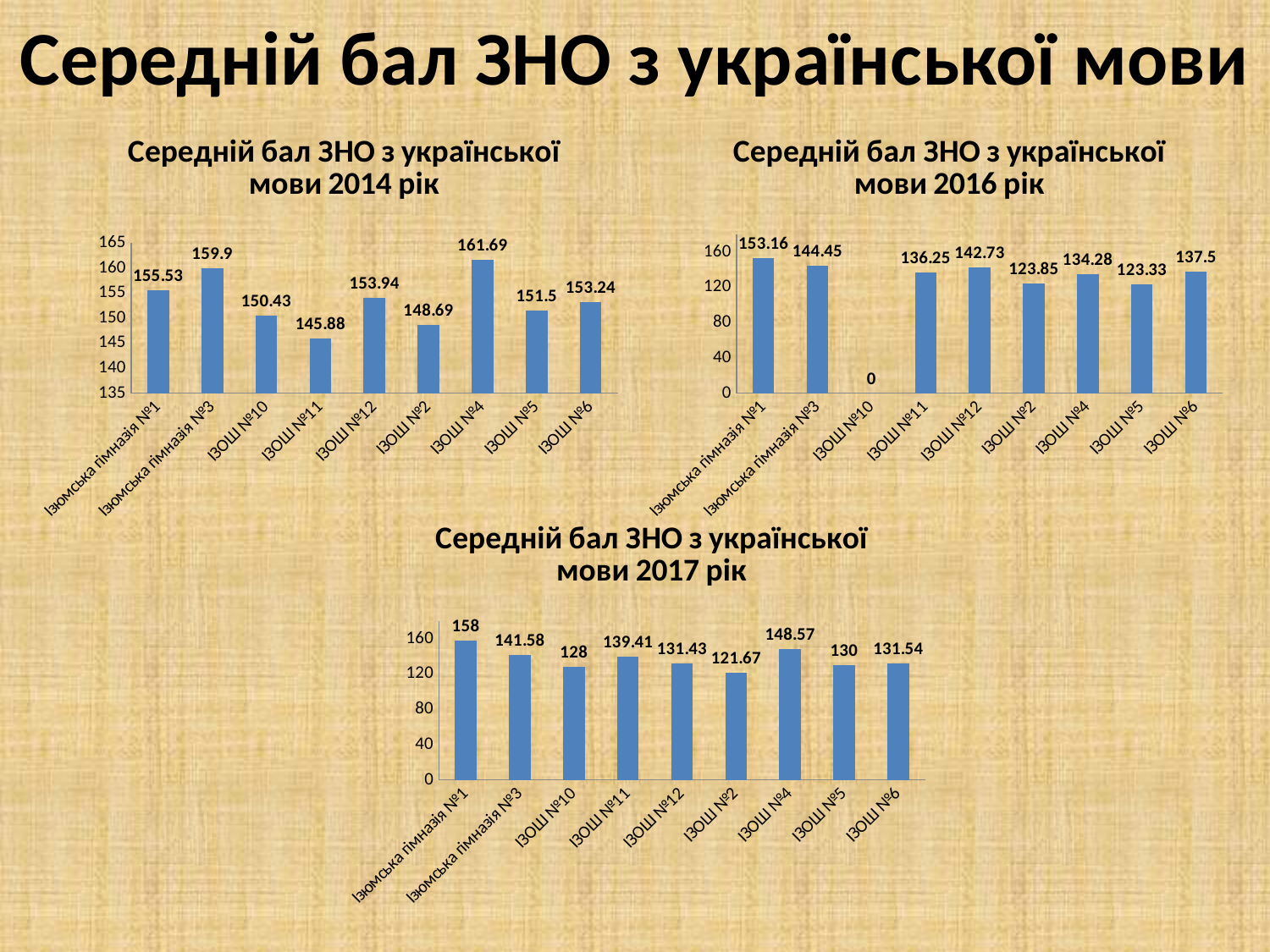
In the 2016 chart, which category has the highest value? Ізюмська гімназія №1 In the 2016 chart, which is larger: ІЗОШ №6 or ІЗОШ №4? ІЗОШ №6 What type of chart is the 2014 chart? Bar chart In the 2014 chart (Середній бал ЗНО з української мови 2014 рік), what is the value for ІЗОШ №4? 161.69 In the 2017 chart (Середній бал ЗНО з української мови 2017 рік), what is the value for ІЗОШ №4? 148.57 In the 2014 chart, what is the difference between Ізюмська гімназія №3 and ІЗОШ №10? 9.47 In the 2016 chart, what value is shown for ІЗОШ №10? 0 In the 2014 chart, which category has the lowest value? ІЗОШ №11 In the 2016 chart (Середній бал ЗНО з української мови 2016 рік), what is the value for ІЗОШ №12? 142.73 In the 2017 chart, what is the difference between Ізюмська гімназія №1 and ІЗОШ №5? 28 How many categories are shown in the 2017 chart? 9 In the 2017 chart, which category has the lowest value? ІЗОШ №2